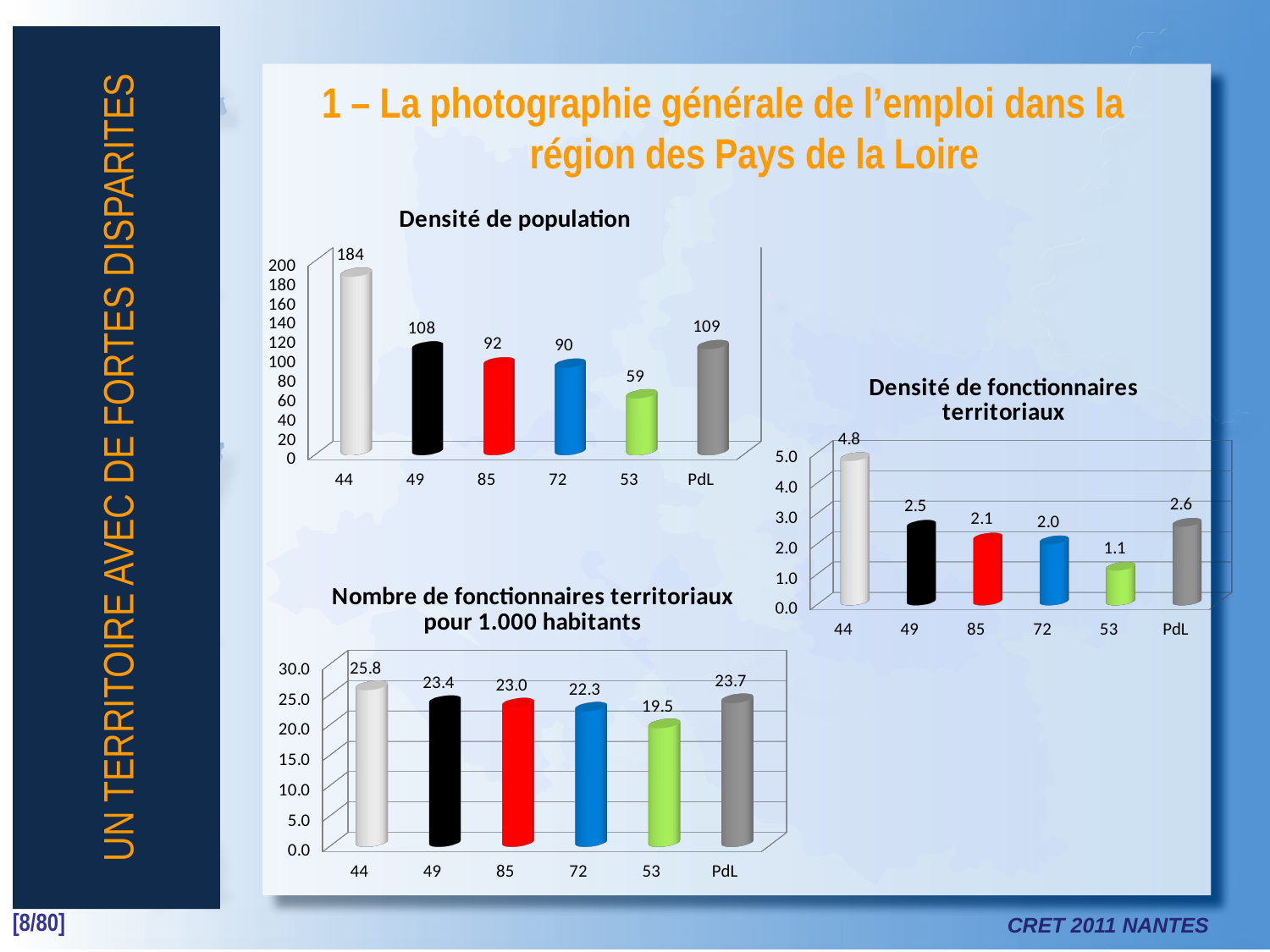
In the 'Densité de fonctionnaires territoriaux' chart, which is larger, the value for 49 or the value for 53? 49 In the 'Densité de population' chart, how many categories are shown on the x axis? 6 In the 'Densité de fonctionnaires territoriaux' chart, what is the value for PdL? 2.6 In the 'Nombre de fonctionnaires territoriaux pour 1.000 habitants' chart, which category has the lowest value? 53 In the 'Densité de population' chart, what is the difference between the values for 44 and PdL? 75 In the 'Densité de fonctionnaires territoriaux' chart, which category has the highest value? 44 In the 'Nombre de fonctionnaires territoriaux pour 1.000 habitants' chart, what is the difference between the values for 44 and 53? 6.3 What kind of chart is the 'Densité de population' chart? bar chart In the 'Densité de population' chart, which category has the lowest value? 53 How many charts are shown on the slide? 3 In the 'Nombre de fonctionnaires territoriaux pour 1.000 habitants' chart, what is the value for category 72? 22.3 In the 'Densité de population' chart, what is the value for category 44? 184